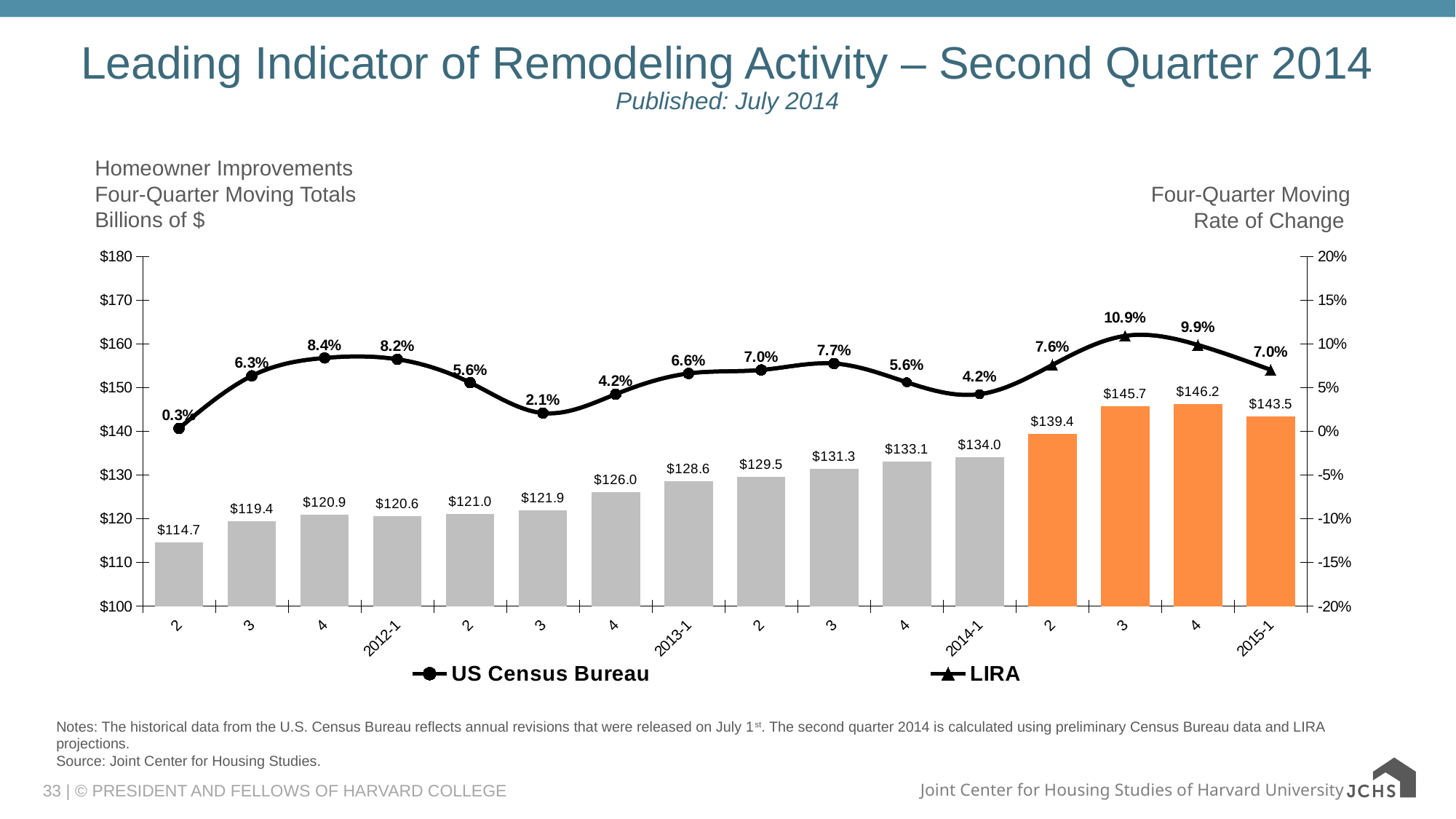
How many bars are plotted on the chart? 16 What is the lowest four-quarter moving total shown by the bars? $114.7 Which quarter has the highest four-quarter moving total bar? 2014-4 ($146.2) What is the lowest four-quarter moving rate of change shown on the line? 0.3% Which is larger, the four-quarter moving total for 2012-1 or for 2013-1? 2013-1 Do the four-quarter moving total bars generally rise or fall from left to right? rise What is the four-quarter moving rate of change shown for 2013-1? 6.6% What is the highest four-quarter moving rate of change shown on the line? 10.9% What is the four-quarter moving total for 2015-1? $143.5 How many series does the legend list? 2 What is the four-quarter moving total (billions of $) for 2014-1? $134.0 What is the difference between the four-quarter moving totals for 2014-4 and 2015-1? $2.7